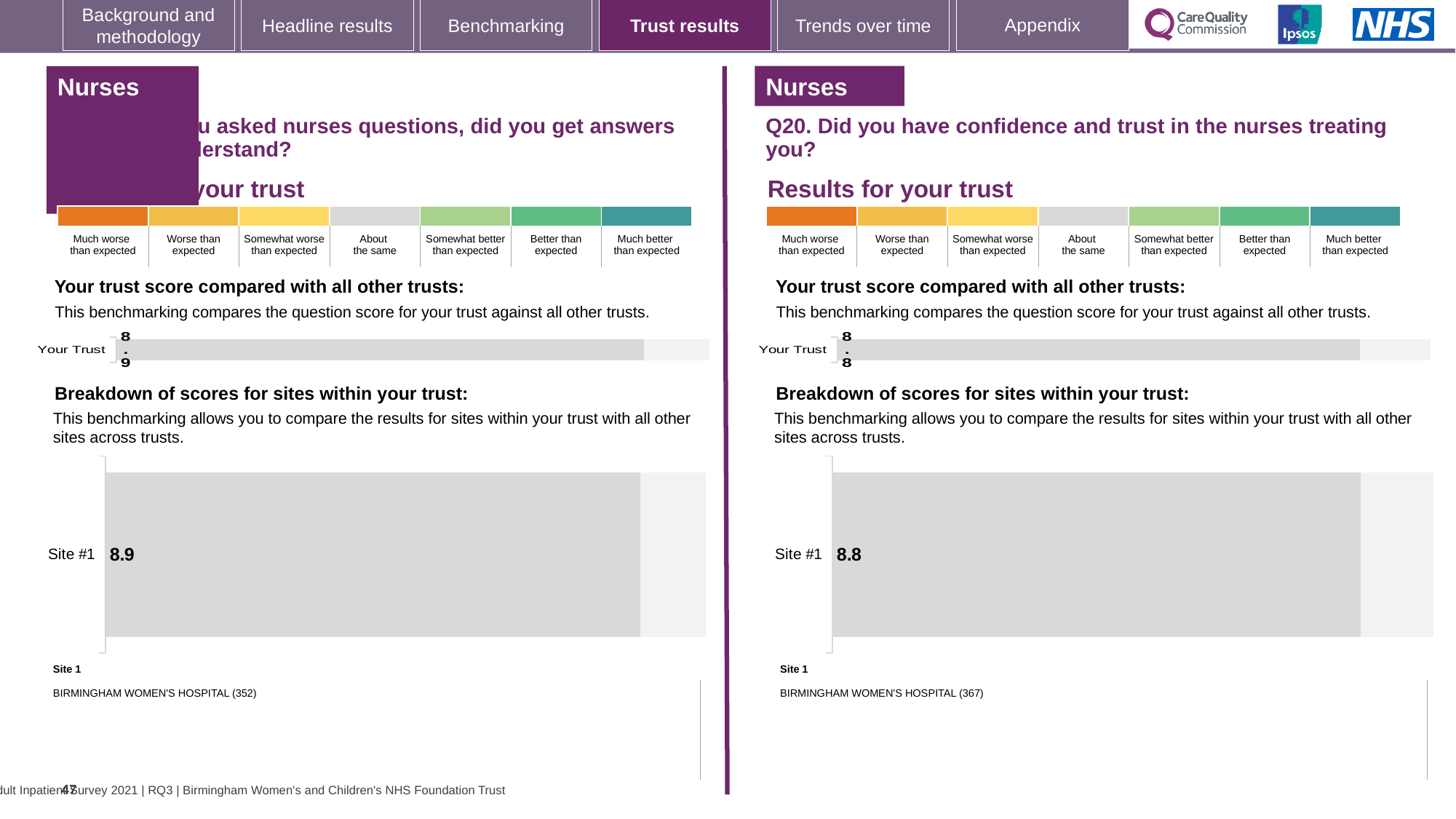
Which is larger: the Your Trust score on the left panel or the Your Trust score on the right panel (Q20)? Left panel (8.9) On the right panel (Q20), what is the score shown for Your Trust in the 'Your trust score compared with all other trusts' chart? 8.8 What type of chart is used to show the Your Trust score on the left panel? Bar chart On the left panel, what score is shown for Site #1 in the 'Breakdown of scores for sites within your trust' chart? 8.9 How many sites are plotted in the 'Breakdown of scores for sites within your trust' chart on the right panel (Q20)? 1 What type of chart is used to show the Site #1 score on the right panel (Q20)? Bar chart On the left panel, which site name is listed as Site 1 below the breakdown chart? BIRMINGHAM WOMEN'S HOSPITAL (352) On the left panel, what is the score shown for Your Trust in the 'Your trust score compared with all other trusts' chart? 8.9 What is the difference between the Site #1 score on the left panel and the Site #1 score on the right panel (Q20)? 0.1 On the right panel (Q20), which site name is listed as Site 1 below the breakdown chart? BIRMINGHAM WOMEN'S HOSPITAL (367) On the right panel (Q20), what score is shown for Site #1 in the 'Breakdown of scores for sites within your trust' chart? 8.8 How many sites are plotted in the 'Breakdown of scores for sites within your trust' chart on the left panel? 1